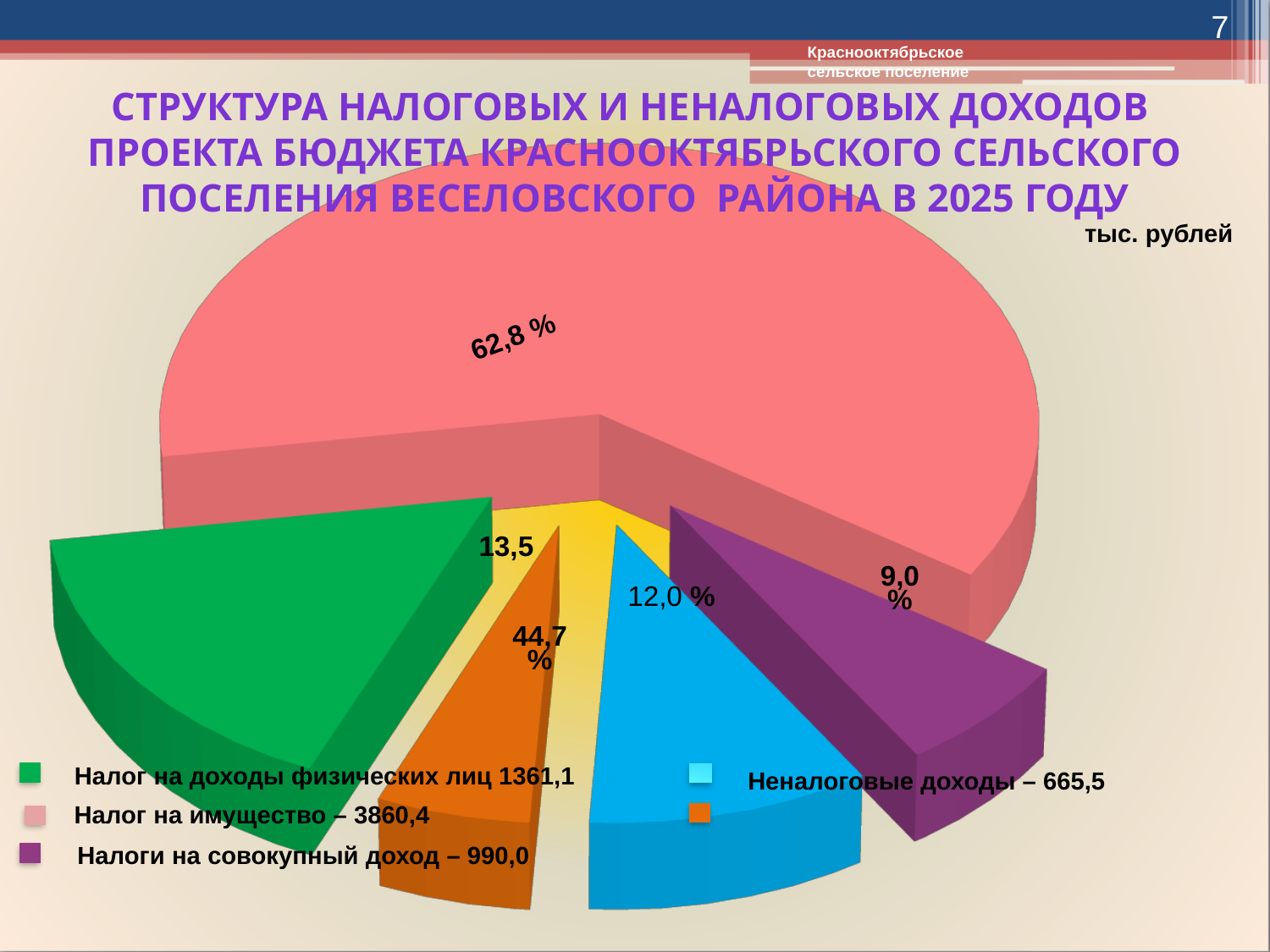
What value is shown in the legend for Неналоговые доходы? 665,5 What value is shown in the legend for Налог на имущество? 3860,4 In what units are the values on the chart given, according to the slide? тыс. рублей Which legend category has the largest value? Налог на имущество What is the difference between the values for Налоги на совокупный доход and Неналоговые доходы? 324,5 What kind of chart is shown on the slide? pie chart Which is larger: the value for Налог на доходы физических лиц or the value for Налоги на совокупный доход? Налог на доходы физических лиц What value is shown in the legend for Налоги на совокупный доход? 990,0 What is the difference between the values for Налог на имущество and Налог на доходы физических лиц? 2499,3 Which legend category has the smallest value? Неналоговые доходы What value is shown in the legend for Налог на доходы физических лиц? 1361,1 What percentage label is shown on the largest (pink) slice of the pie? 62,8 %